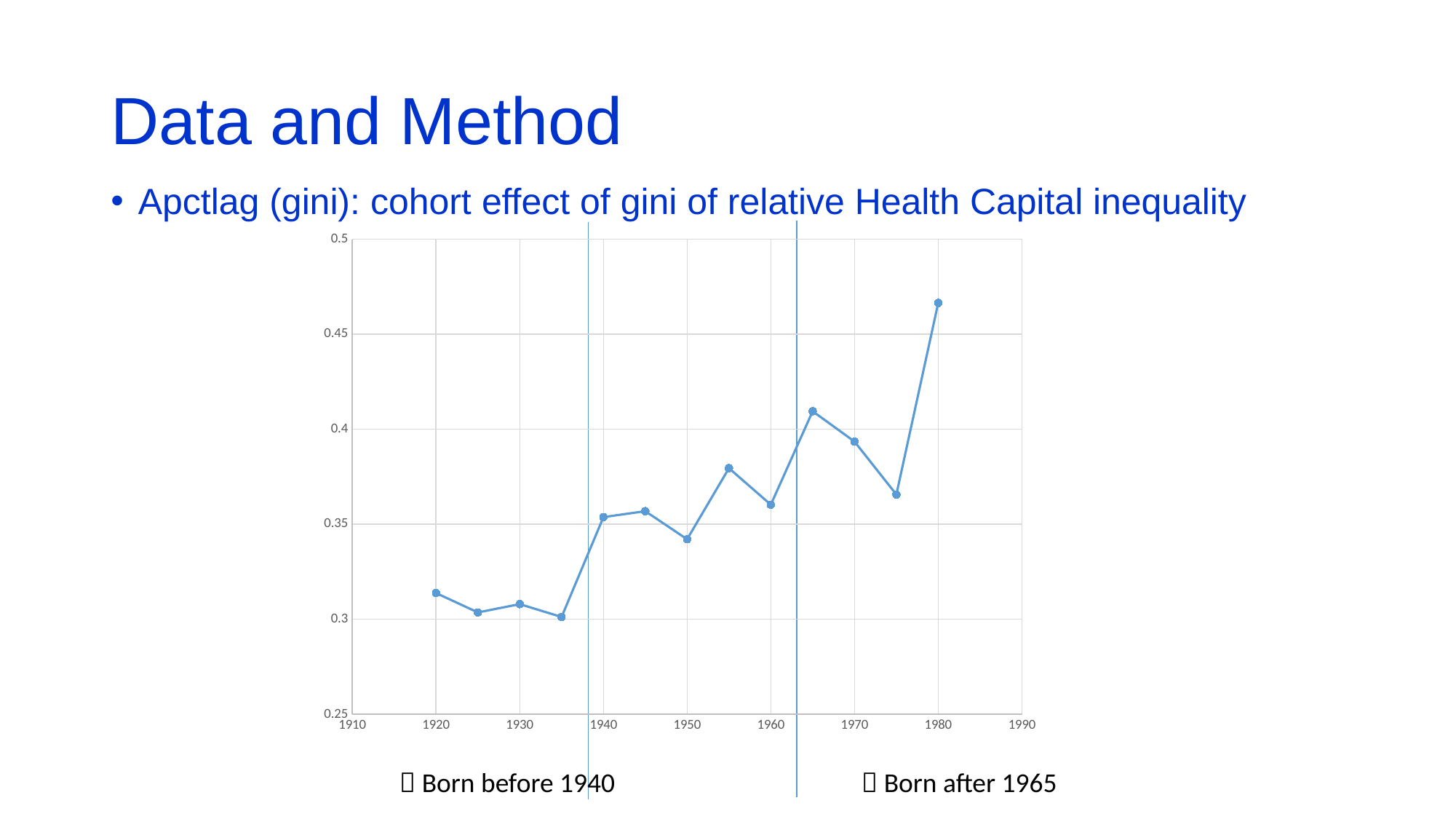
Is the value for 1950 greater or less than 0.35? less How many data points are plotted on the line chart? 13 Is the value for 1935 greater or less than 0.35? less Which is larger, the value for 1975 or the value for 1965? 1965 Which year has the highest value on the line chart? 1980 Overall, do the values rise or fall from 1920 to 1980? rise Which is larger, the value for 1940 or the value for 1930? 1940 Is the value for 1955 greater or less than 0.35? greater What label is shown to the left of the first vertical line below the chart? Born before 1940 What kind of chart is shown on the slide? line chart